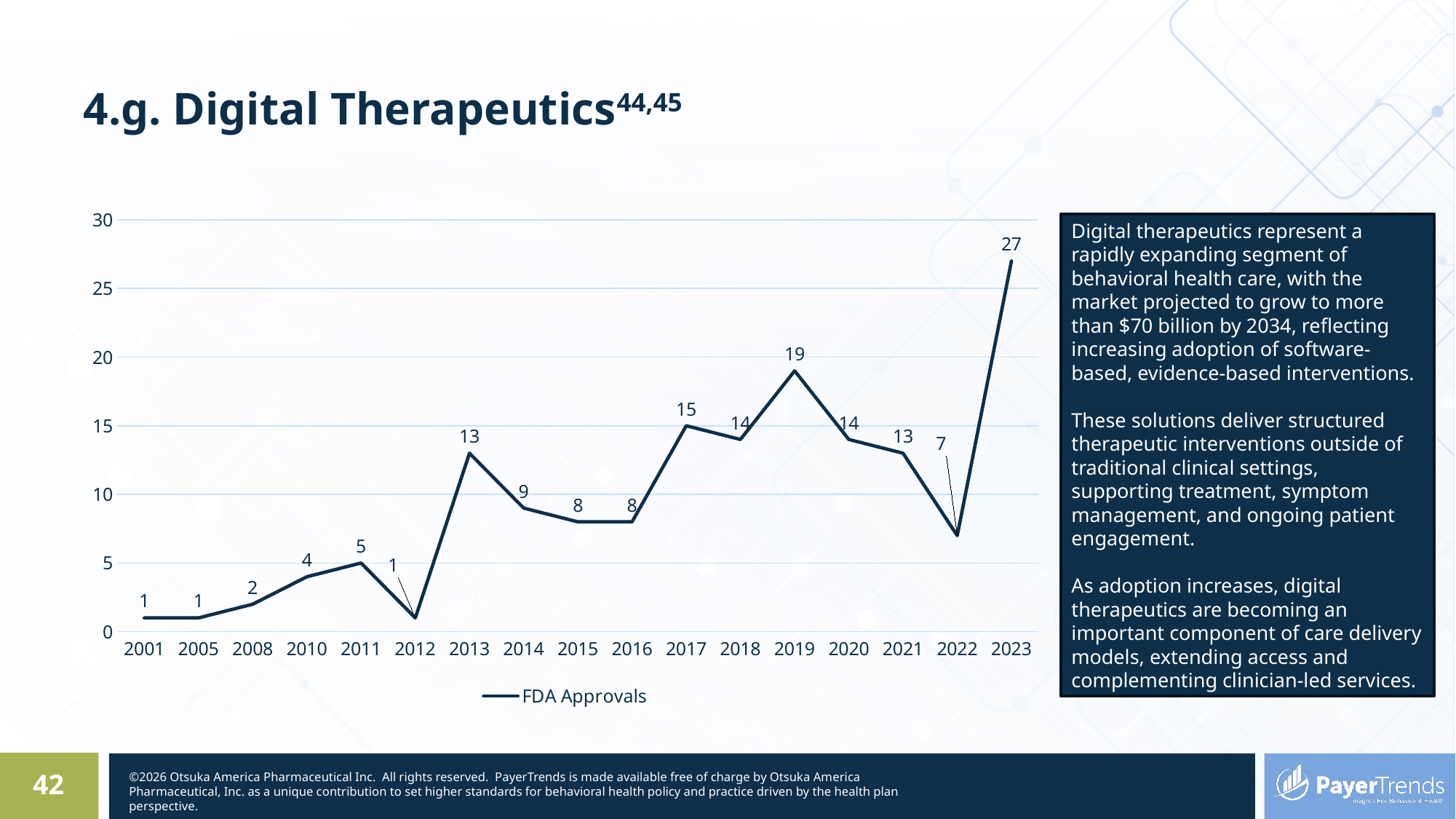
What is the difference in FDA approvals between 2023 and 2022? 20 Which year has more FDA approvals, 2017 or 2018? 2017 Which year has the highest number of FDA approvals? 2023 How many years are plotted on the x axis? 17 What is the difference in FDA approvals between 2013 and 2014? 4 What is the value for FDA Approvals in 2012? 1 How many series does the legend list? 1 What type of chart is shown on the slide? Line chart How many FDA approvals are shown for 2023? 27 What is the name of the series shown in the legend? FDA Approvals What is the value for FDA Approvals in 2019? 19 Is the value for 2013 greater or less than 10? greater